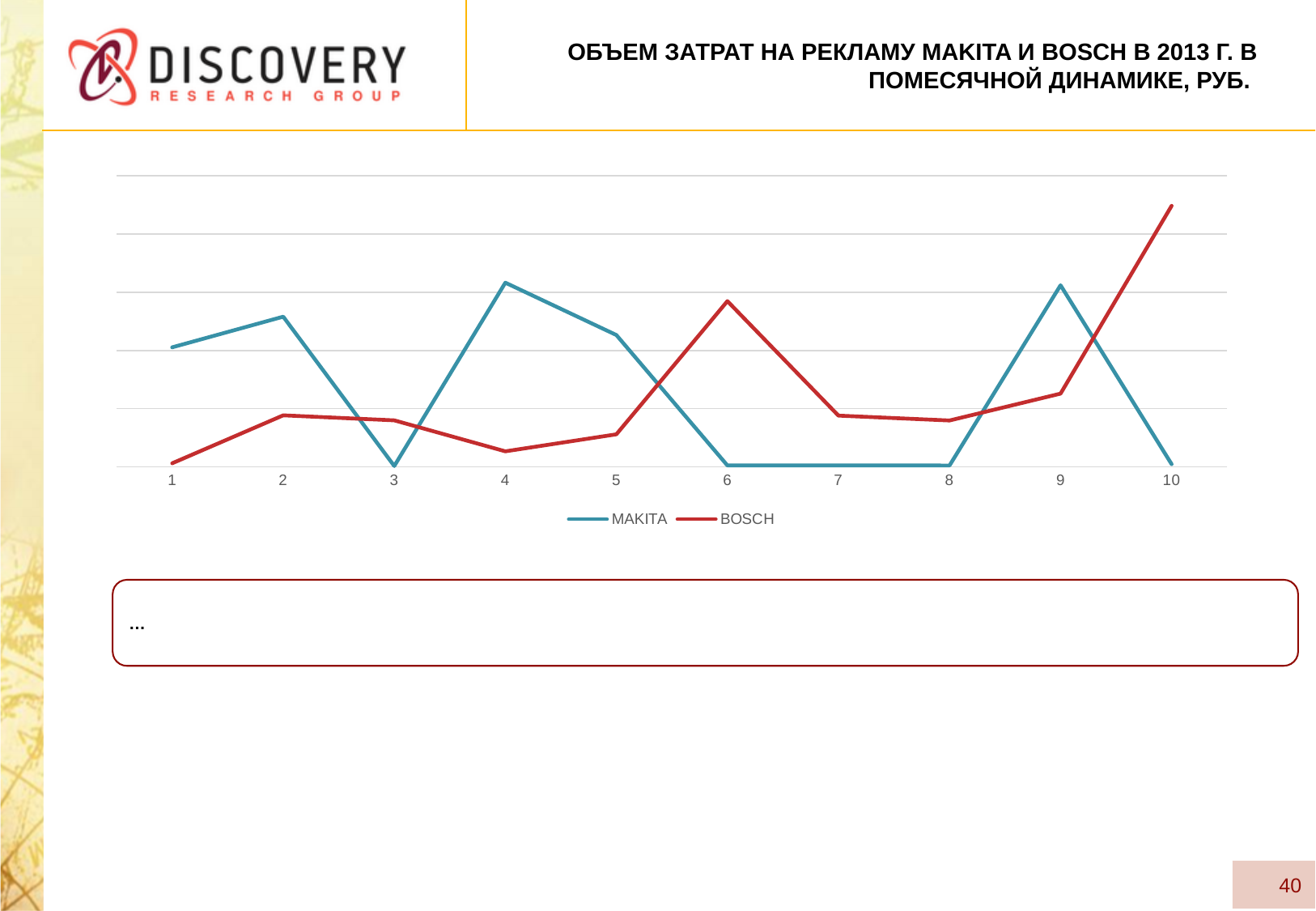
What kind of chart is shown on the slide? Line chart Does the MAKITA series rise or fall from point 9 to point 10? Fall At point 10, which series has the larger value, MAKITA or BOSCH? BOSCH At which x-axis point does the BOSCH series have its lowest value? 1 At which x-axis point does the BOSCH series reach its highest value? 10 What is the title of the chart? ОБЪЕМ ЗАТРАТ НА РЕКЛАМУ MAKITA И BOSCH В 2013 Г. В ПОМЕСЯЧНОЙ ДИНАМИКЕ, РУБ. At point 6, which series has the larger value, MAKITA or BOSCH? BOSCH At point 2, which series has the larger value, MAKITA or BOSCH? MAKITA How many points are plotted along the x axis for each series? 10 Does the BOSCH series rise or fall from point 8 to point 10? Rise How many series does the legend list? 2 Which series is drawn in red? BOSCH